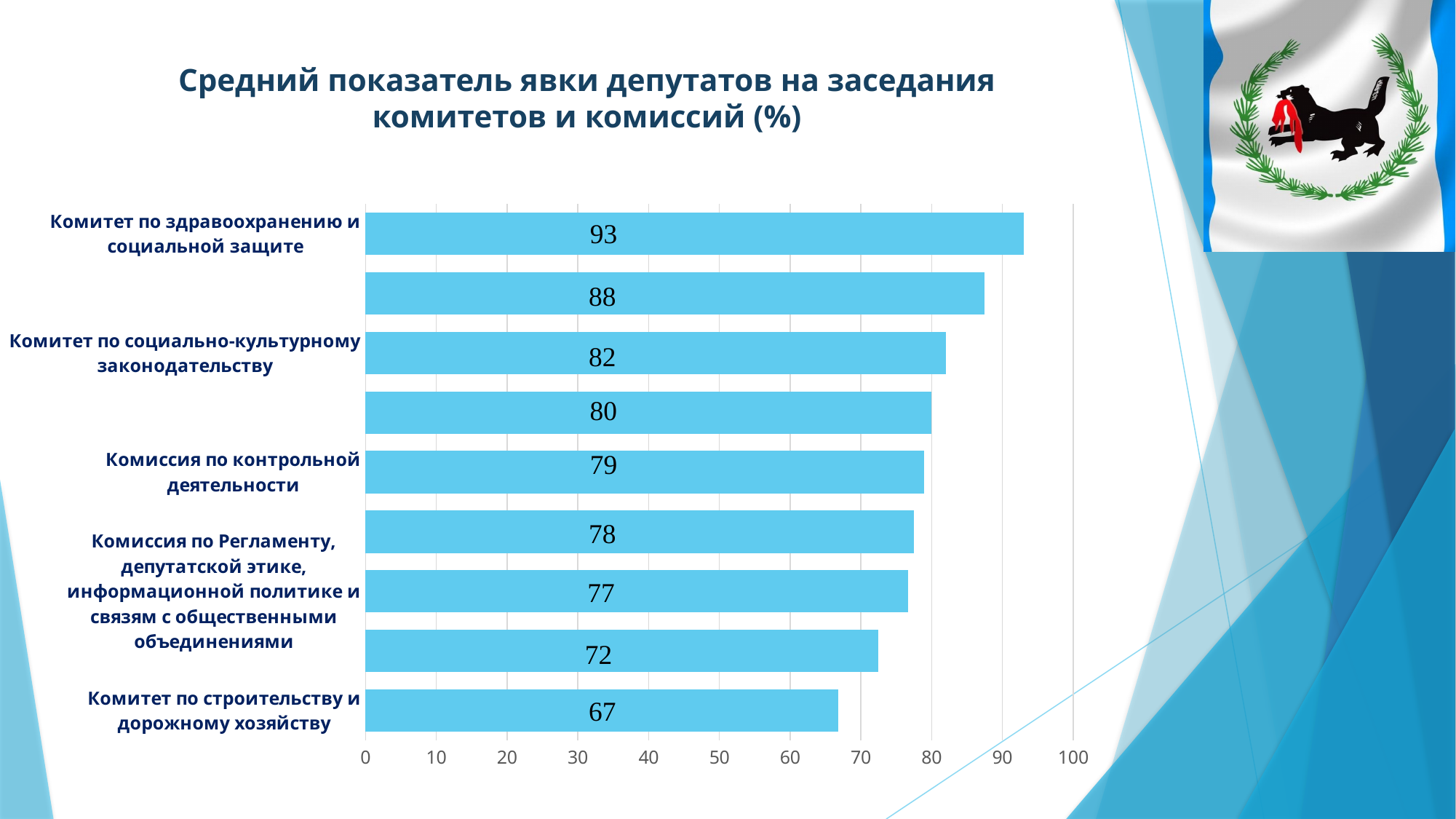
What is the average attendance value for Комитет по здравоохранению и социальной защите? 93 How many bars are plotted in the chart? 9 Which committee or commission has the lowest average attendance? Комитет по строительству и дорожному хозяйству What is the value shown for Комиссия по контрольной деятельности? 79 What is the difference between the values for Комитет по социально-культурному законодательству and Комиссия по контрольной деятельности? 3 Which committee or commission has the highest average attendance? Комитет по здравоохранению и социальной защите Which is larger: the value for Комиссия по контрольной деятельности or the value for Комитет по строительству и дорожному хозяйству? Комиссия по контрольной деятельности What is the difference between the values for Комитет по здравоохранению и социальной защите and Комитет по строительству и дорожному хозяйству? 26 What is the title of the chart? Средний показатель явки депутатов на заседания комитетов и комиссий (%) What is the value shown for Комитет по строительству и дорожному хозяйству? 67 What kind of chart is shown on the slide? Bar chart What is the value shown for Комитет по социально-культурному законодательству? 82